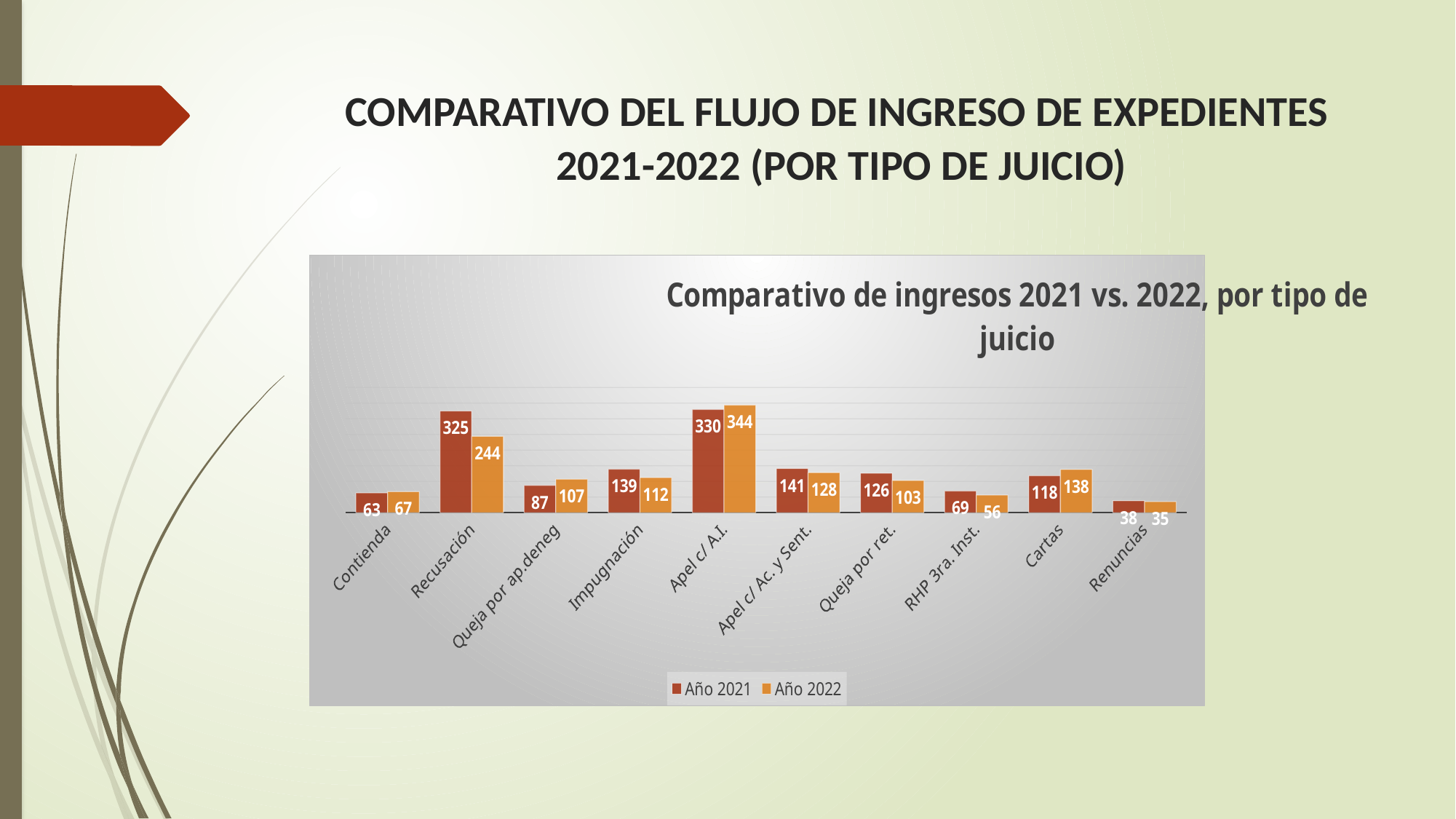
What are the two series listed in the legend? Año 2021 and Año 2022 How many series does the legend list? 2 What kind of chart is shown on the slide? Bar chart Which is larger for Impugnación: the Año 2021 value or the Año 2022 value? Año 2021 What is the value for Recusación in Año 2021? 325 What is the value for Apel c/ A.I. in Año 2022? 344 Which category has the lowest value in Año 2021? Renuncias Which category has the highest value in Año 2022? Apel c/ A.I. How many categories are shown on the x axis? 10 What is the value for Cartas in Año 2022? 138 What is the difference between the Año 2022 and Año 2021 values for Cartas? 20 What is the difference between the Año 2021 and Año 2022 values for Recusación? 81